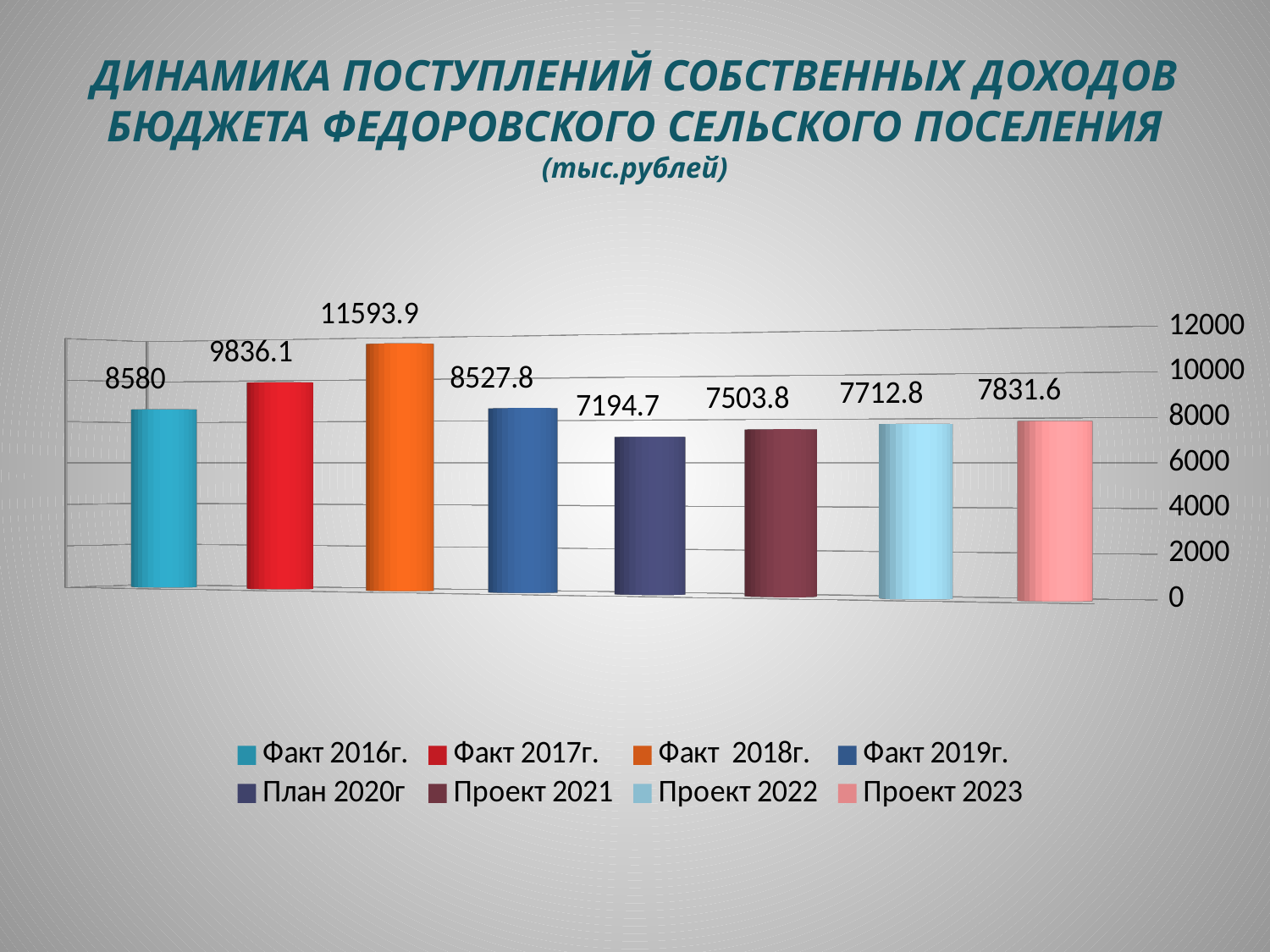
Which series has the lowest value? План 2020г What is the value for Факт 2018г.? 11593.9 Which is larger, the value for Факт 2017г. or the value for Факт 2019г.? Факт 2017г. What is the difference between the values for Факт 2018г. and Факт 2017г.? 1757.8 Is the value for Проект 2022 greater or less than 8000? less What is the value for Проект 2023? 7831.6 What is the difference between the values for Проект 2023 and План 2020г? 636.9 What kind of chart is shown on the slide? bar chart Do the values rise or fall from Проект 2021 to Проект 2023? rise How many series does the legend list? 8 What is the value for План 2020г? 7194.7 Which series has the highest value? Факт 2018г.